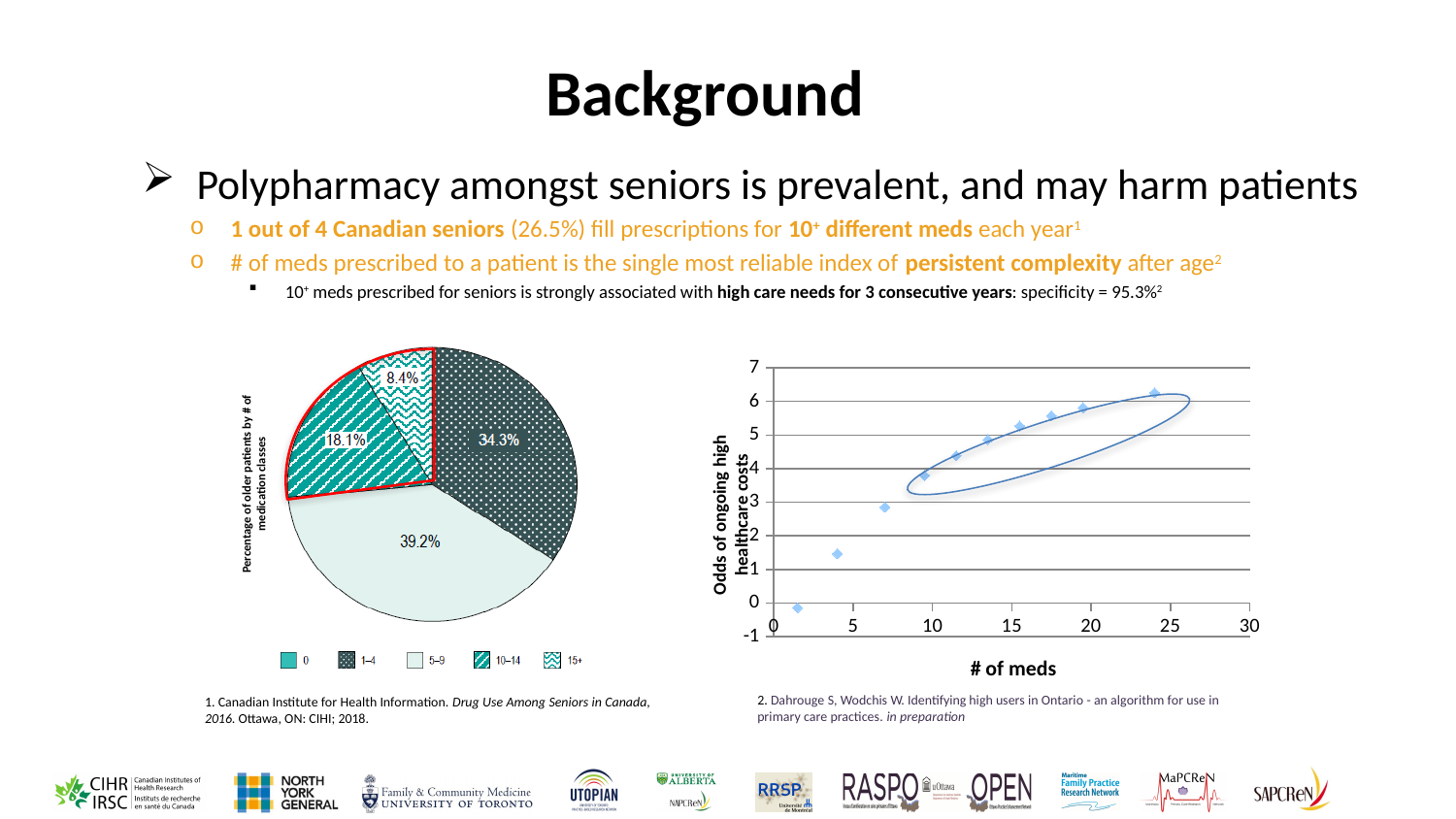
In the pie chart on the left, what is the combined share of the 10–14 and 15+ slices? 26.5% How many data points are plotted in the scatter chart on the right? 10 In the pie chart on the left, what percentage of older patients are in the 1–4 medication classes category? 34.3% In the pie chart on the left, which medication class category has the largest share? 5–9 How many categories does the legend of the pie chart on the left list? 5 In the scatter chart on the right, is the odds value for the point at about 4 meds greater or less than 2? less In the pie chart on the left, what percentage is shown for the 15+ medication classes slice? 8.4% In the pie chart on the left, what is the difference between the 5–9 slice and the 1–4 slice? 4.9% In the scatter chart on the right, do the odds of ongoing high healthcare costs rise or fall as the number of meds increases? Rise What type of chart is the chart on the right of the slide? Scatter chart In the pie chart on the left, what percentage of older patients are in the 5–9 medication classes category? 39.2% In the pie chart on the left, which slice is larger: 1–4 or 10–14? 1–4